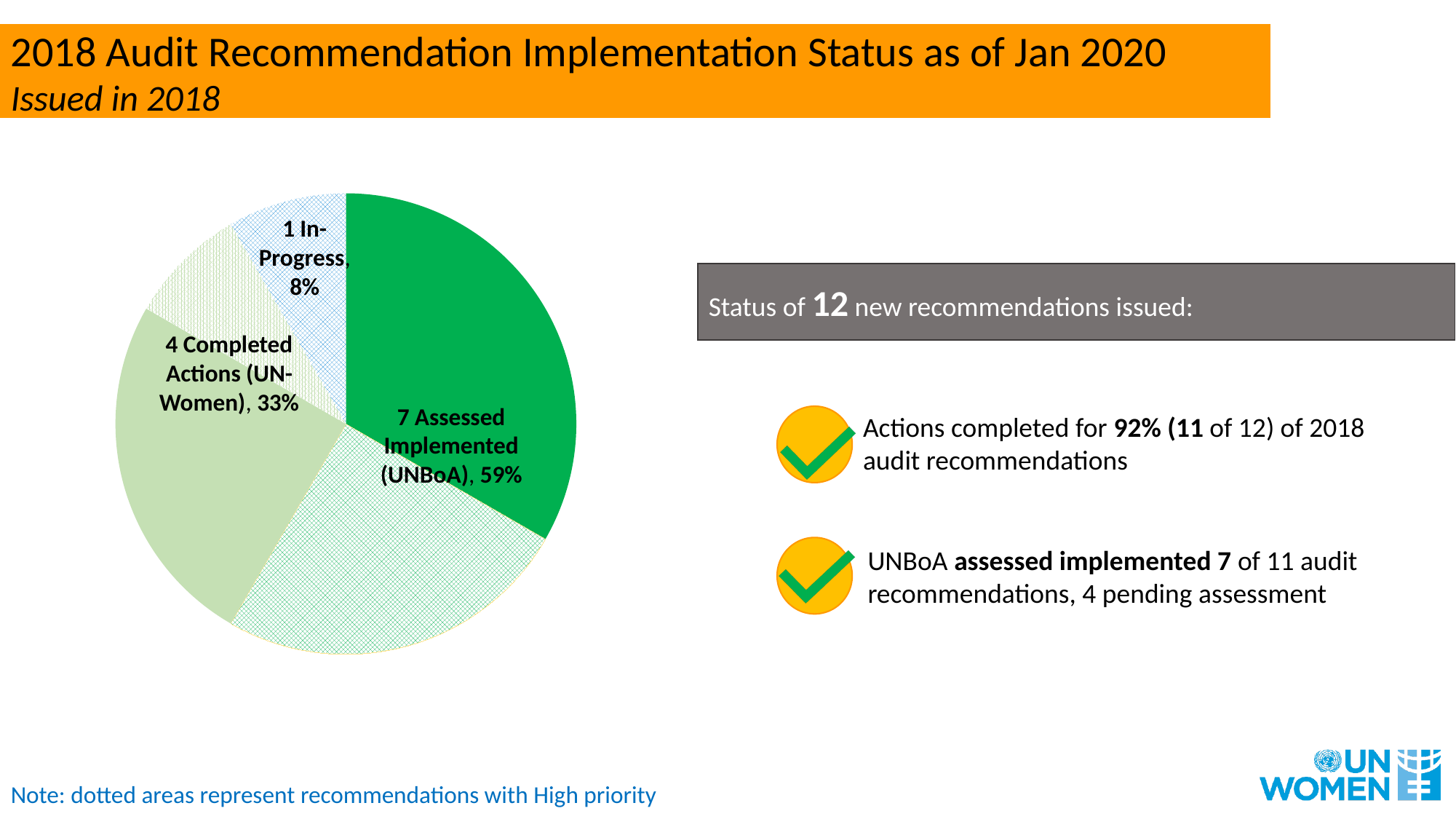
How many recommendations are labelled as In-Progress? 1 Which slice of the pie chart is the smallest? In-Progress What share of the pie is labelled Completed Actions (UN-Women)? 33% According to the note on the slide, what do the dotted areas of the pie chart represent? Recommendations with High priority What share of the pie is labelled Assessed Implemented (UNBoA)? 59% Which slice of the pie chart is the largest? Assessed Implemented (UNBoA) What share of the pie is labelled In-Progress? 8% What is the difference in count between the Assessed Implemented (UNBoA) slice and the Completed Actions (UN-Women) slice? 3 How many slices does the pie chart have? 5 What kind of chart is shown on the slide? pie chart How many recommendations are labelled as Assessed Implemented (UNBoA)? 7 How many recommendations are labelled as Completed Actions (UN-Women)? 4